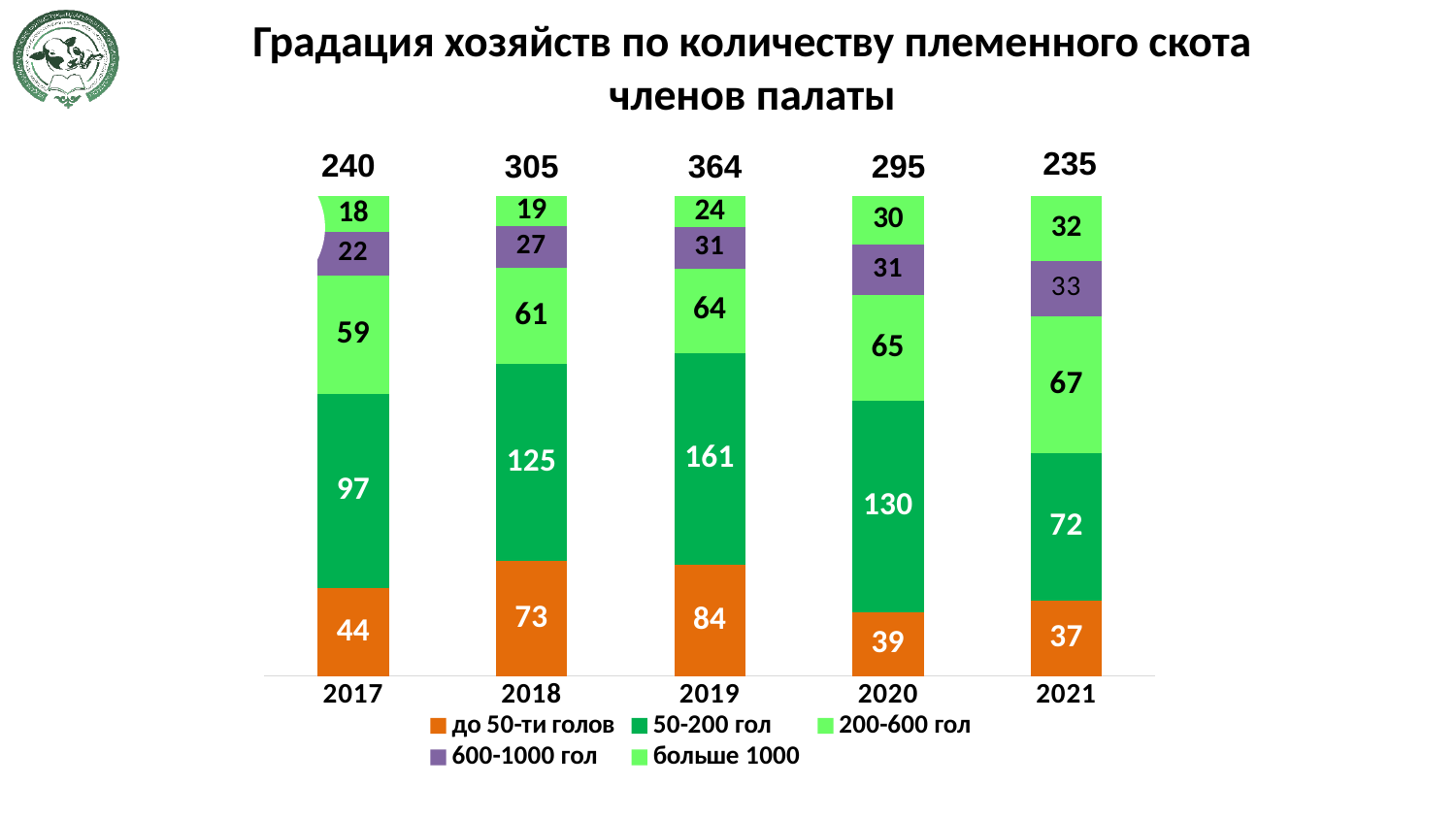
What is the value for the '600-1000 гол' series in 2021? 33 How many series does the legend list? 5 How many years (categories) are shown on the x axis? 5 What is the value for the 'до 50-ти голов' series in 2020? 39 What type of chart is shown on the slide? Stacked bar chart What is the difference between the 'до 50-ти голов' values for 2019 and 2017? 40 What is the total of the stacked bar for 2018? 305 Which is larger: the '50-200 гол' value in 2018 or in 2020? 2020 Which year has the lowest total? 2021 Which year has the highest total? 2019 Which series is shown in orange in the legend? до 50-ти голов What is the value for the '50-200 гол' series in 2019? 161